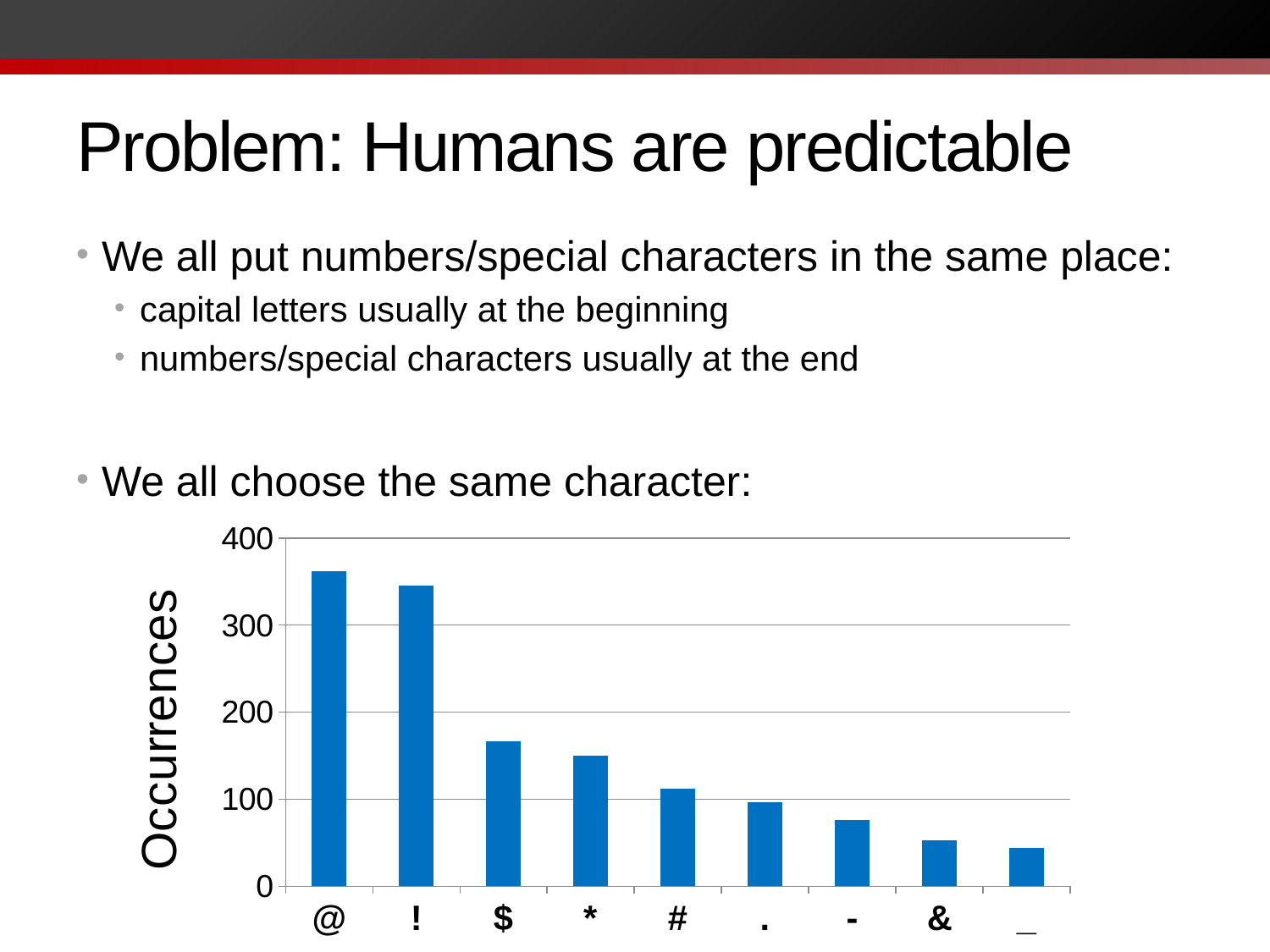
Which character has the highest number of occurrences? @ Is the value for - greater or less than 100? less What is the label on the y axis of the chart? Occurrences Is the value for @ greater or less than 300? greater Is the value for $ greater or less than 200? less What kind of chart is shown on the slide? bar chart How many characters are shown on the x axis of the chart? 9 Do the values rise or fall moving from left to right along the x axis? fall Which has more occurrences, @ or $? @